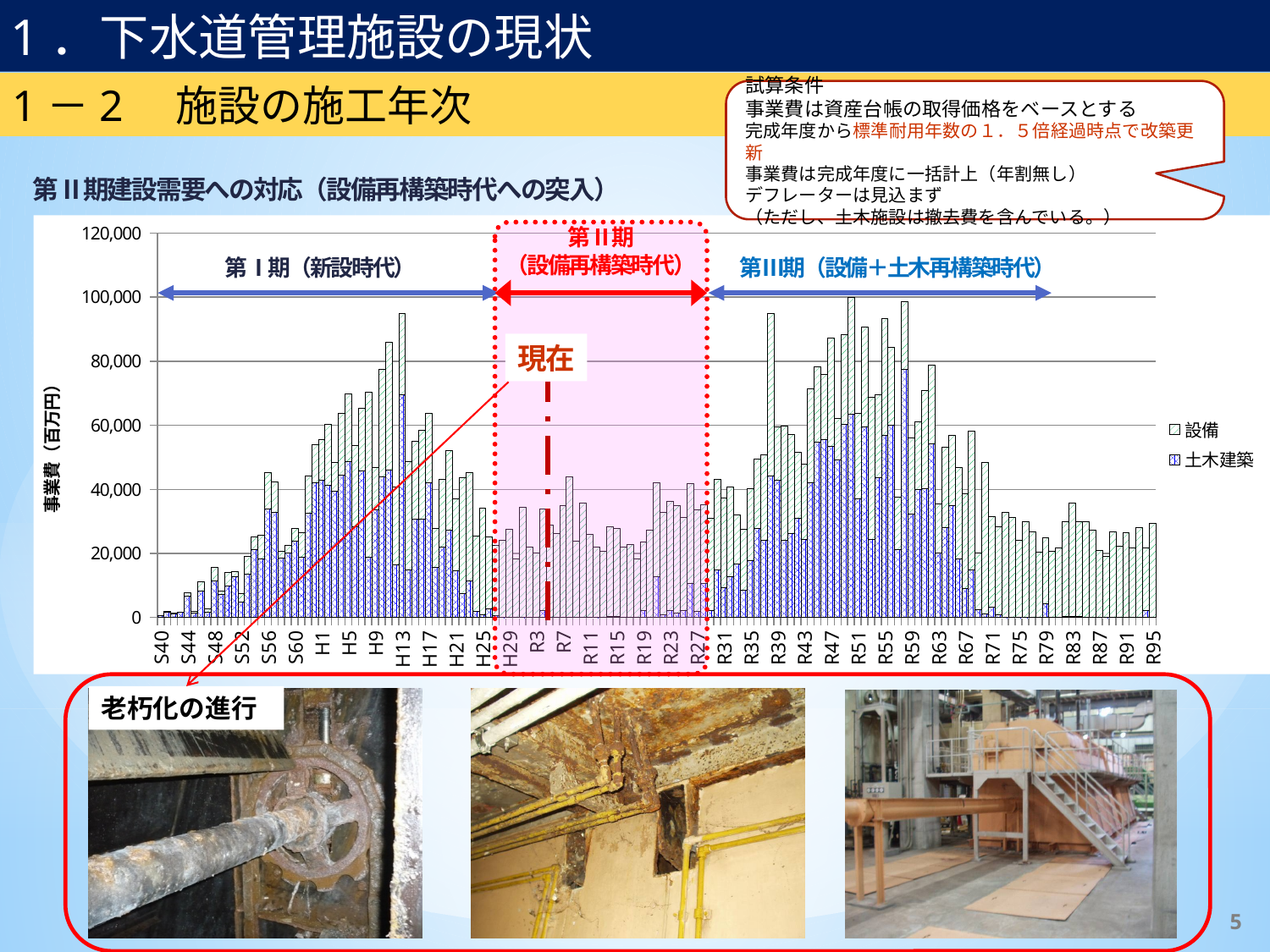
Is the total value for R95 greater or less than 20,000? greater Which has the larger total value, H13 or S40? H13 How many series does the chart legend list? 2 What kind of chart is shown on the slide? bar chart Is the total value for H13 greater or less than 80,000? greater Do the total values generally rise or fall from S40 to H13? rise What are the two series named in the chart legend? 設備, 土木建築 What is the label of the vertical axis of the chart? 事業費（百万円） Is the total value for S40 greater or less than 20,000? less Which has the larger total value, R39 or R19? R39